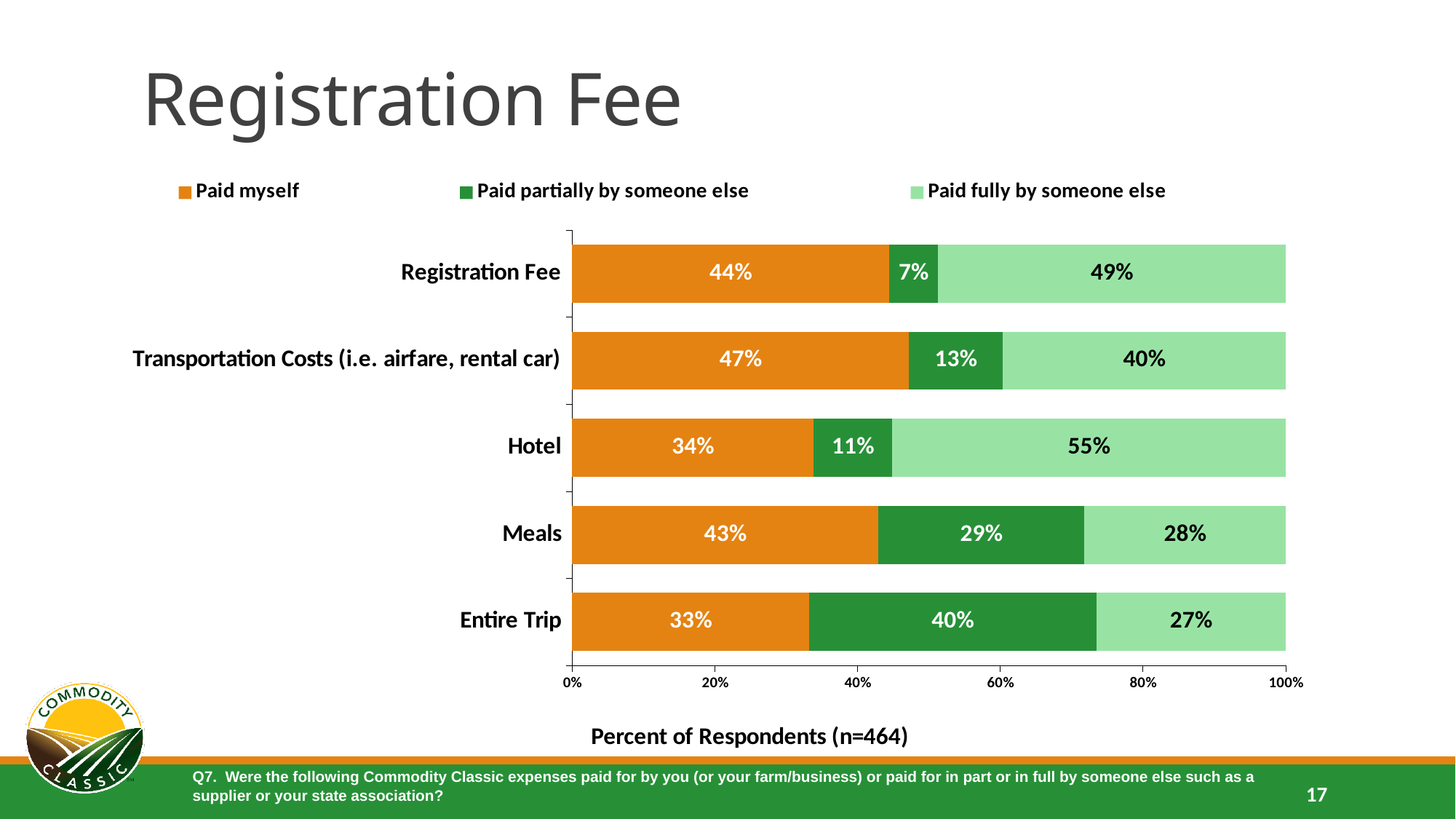
What percentage of respondents had their Hotel paid fully by someone else? 55% What is the total of the stacked bar for Entire Trip? 100% What percentage of respondents paid the Registration Fee themselves? 44% What is the difference between the 'Paid myself' values for Transportation Costs and Entire Trip? 14% Which category has the highest 'Paid fully by someone else' value? Hotel What percentage of respondents had Meals paid partially by someone else? 29% Which is larger: the 'Paid fully by someone else' value for Registration Fee or for Transportation Costs? Registration Fee Which category has the lowest 'Paid partially by someone else' value? Registration Fee What kind of chart is shown on the slide? Stacked bar chart How many expense categories are shown in the chart? 5 What is the x-axis label of the chart? Percent of Respondents (n=464) How many series does the legend list? 3